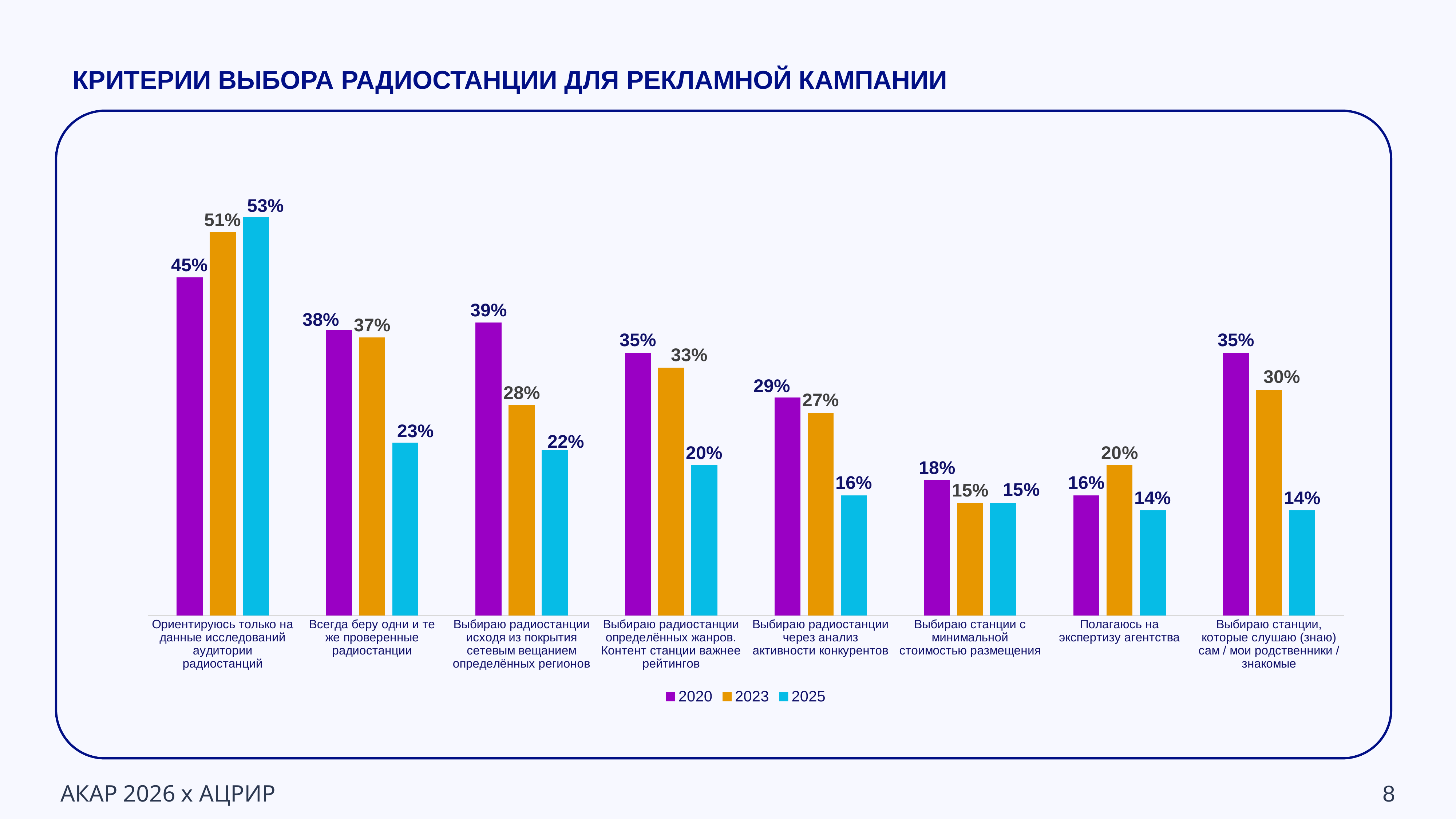
What is the 2020 value for "Полагаюсь на экспертизу агентства"? 16% For "Выбираю радиостанции исходя из покрытия сетевым вещанием определённых регионов", do the values rise or fall from 2020 to 2025? Fall How many series does the legend list? 3 What is the difference between the 2020 and 2025 values for "Выбираю станции, которые слушаю (знаю) сам / мои родственники / знакомые"? 21% Which category has the highest 2025 value? Ориентируюсь только на данные исследований аудитории радиостанций Which series is shown in purple in the legend? 2020 Which category has the lowest 2020 value? Полагаюсь на экспертизу агентства How many categories are shown on the x axis? 8 What is the 2025 value for "Ориентируюсь только на данные исследований аудитории радиостанций"? 53% What kind of chart is shown on the slide? Bar chart What is the 2023 value for "Выбираю радиостанции определённых жанров. Контент станции важнее рейтингов"? 33% For "Всегда беру одни и те же проверенные радиостанции", which is larger: the 2020 value or the 2025 value? 2020